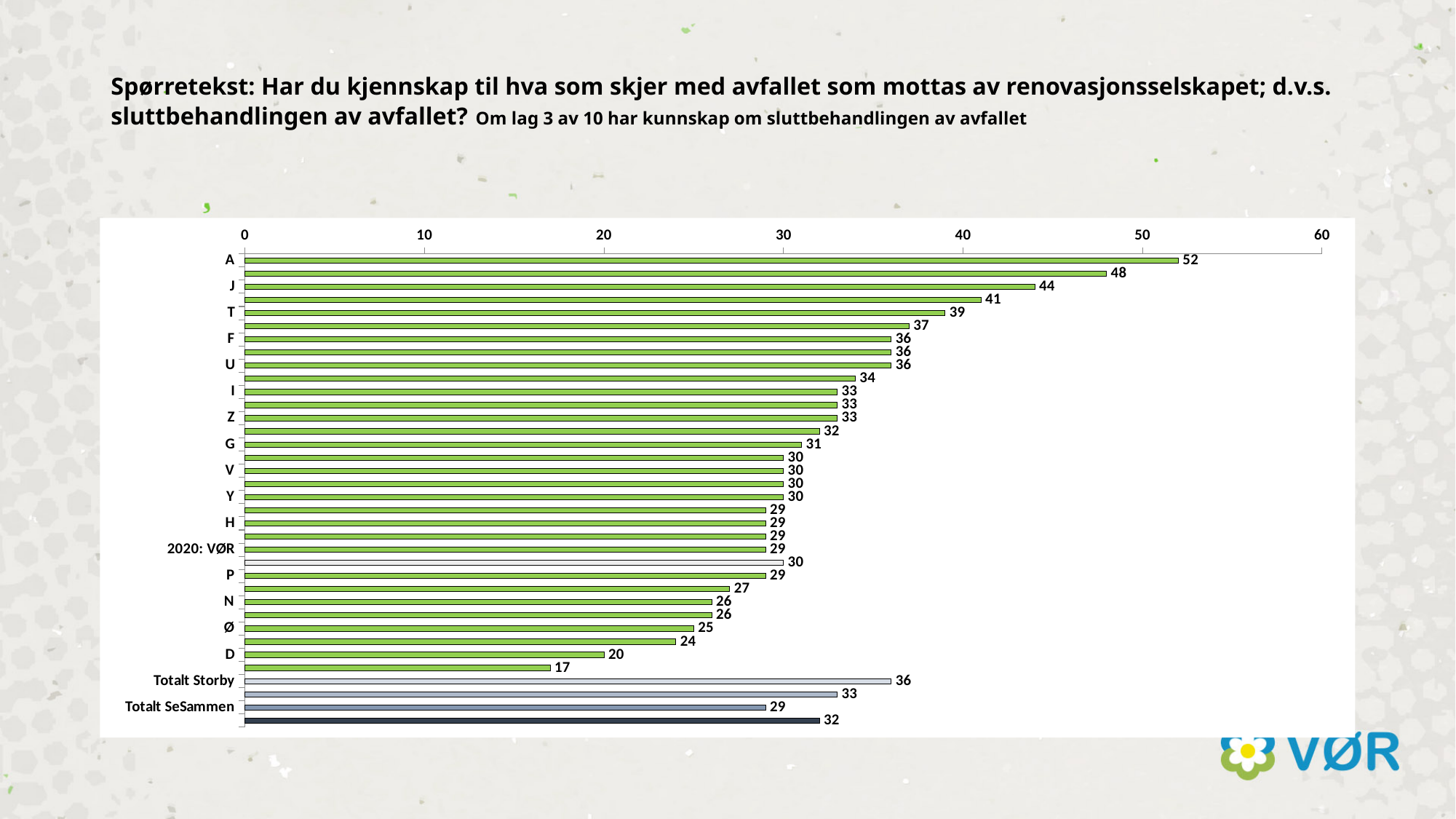
What is the value for D? 20 What is the value for J? 44 What is the highest value shown on the horizontal axis? 60 What is the value for 2020: VØR? 29 Which labelled category has the highest value? A What is the difference between the values for A and J? 8 What is the value for Totalt Storby? 36 What type of chart is shown on the slide? bar chart What is the value for Totalt SeSammen? 29 What is the value for A? 52 What is the value for T? 39 Which is larger, the value for A or the value for T? A